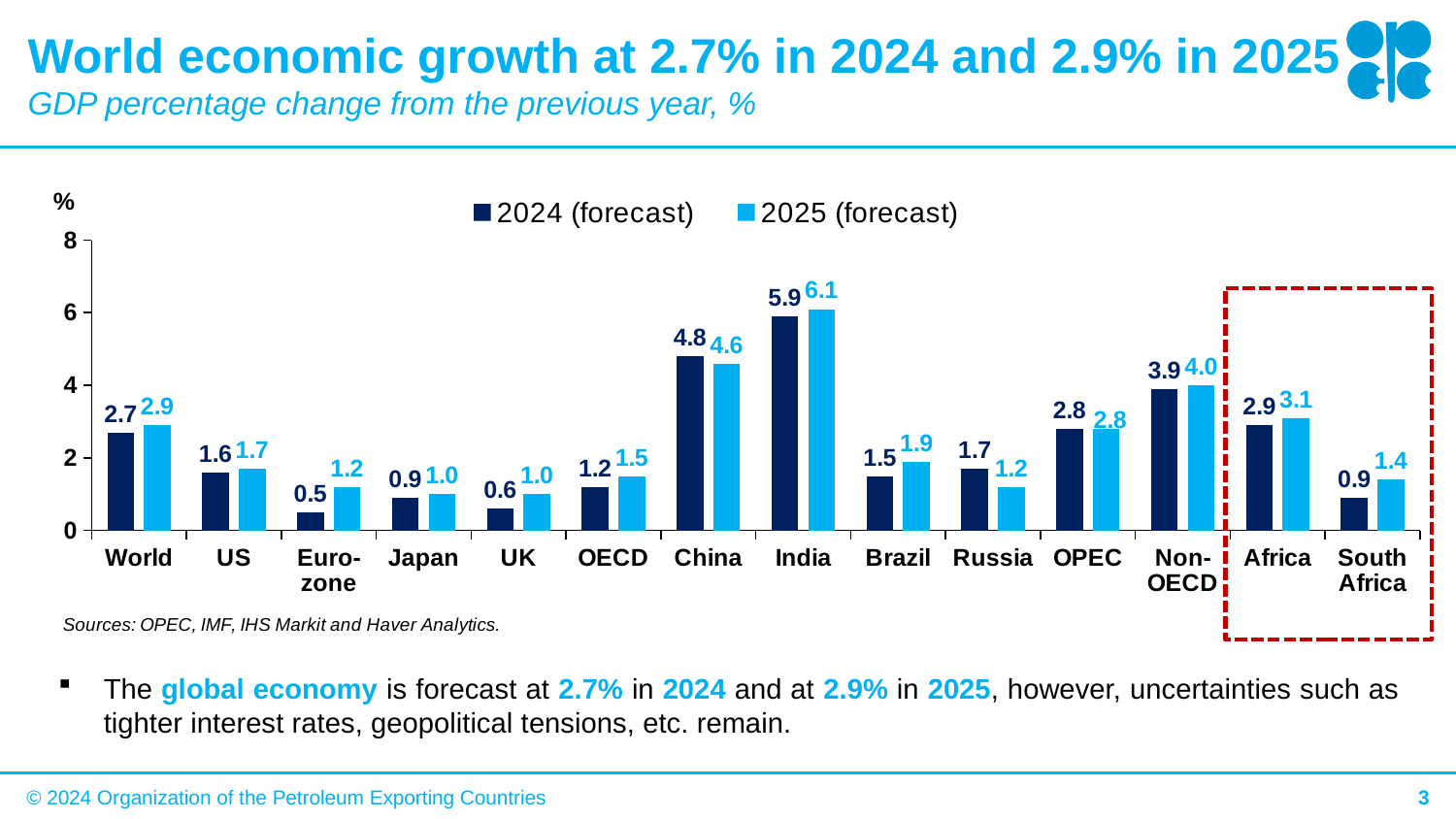
Which category has the lowest 2024 (forecast) value? Euro-zone What kind of chart is shown on the slide? bar chart What is the 2025 (forecast) GDP growth value for Brazil? 1.9 Which is larger for China: the 2024 (forecast) value or the 2025 (forecast) value? 2024 (forecast) What is the 2024 (forecast) GDP growth value for India? 5.9 Is the 2024 (forecast) value for Non-OECD greater or less than 2? greater What is the difference between the 2025 (forecast) and 2024 (forecast) values for South Africa? 0.5 How many categories are shown on the x axis? 14 What is the 2025 (forecast) value for Russia? 1.2 How many series does the legend list? 2 Which two categories are enclosed by the red dashed box? Africa and South Africa Which category has the highest 2025 (forecast) value? India